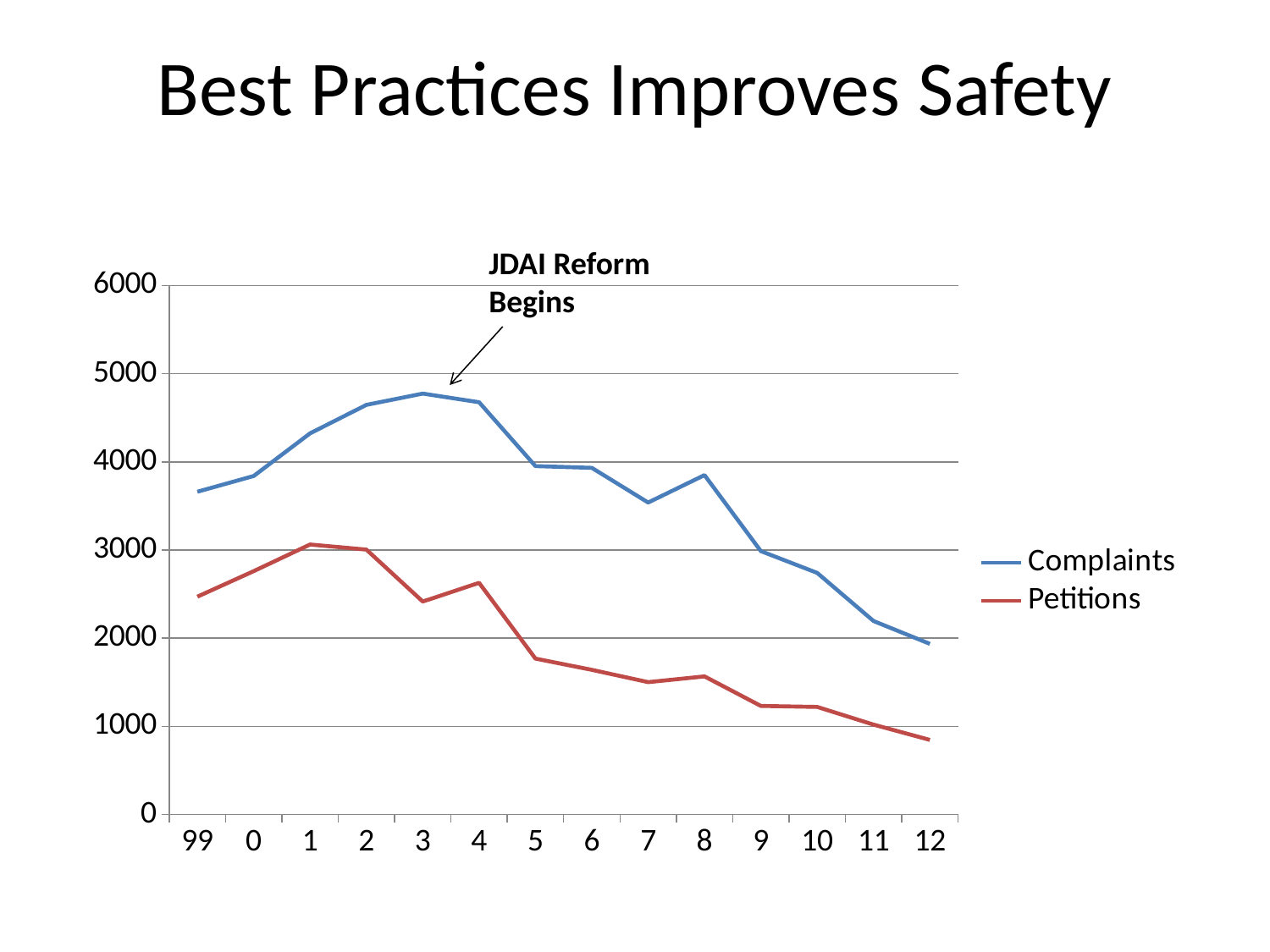
At which x-axis label does the Petitions series reach its highest value? 1 What kind of chart is shown on the slide? line chart At which x-axis label does the Petitions series reach its lowest value? 12 How many series does the legend list? 2 Is the value for Complaints at 3 greater or less than 4000? greater Do the Complaints values rise or fall from 4 to 12 along the x axis? fall What event does the annotation with the arrow on the chart mark? JDAI Reform Begins Is the value for Petitions at 12 greater or less than 1000? less Which series has the larger value at 5, Complaints or Petitions? Complaints How many points are plotted along the x axis for each series? 14 At which x-axis label does the Complaints series reach its highest value? 3